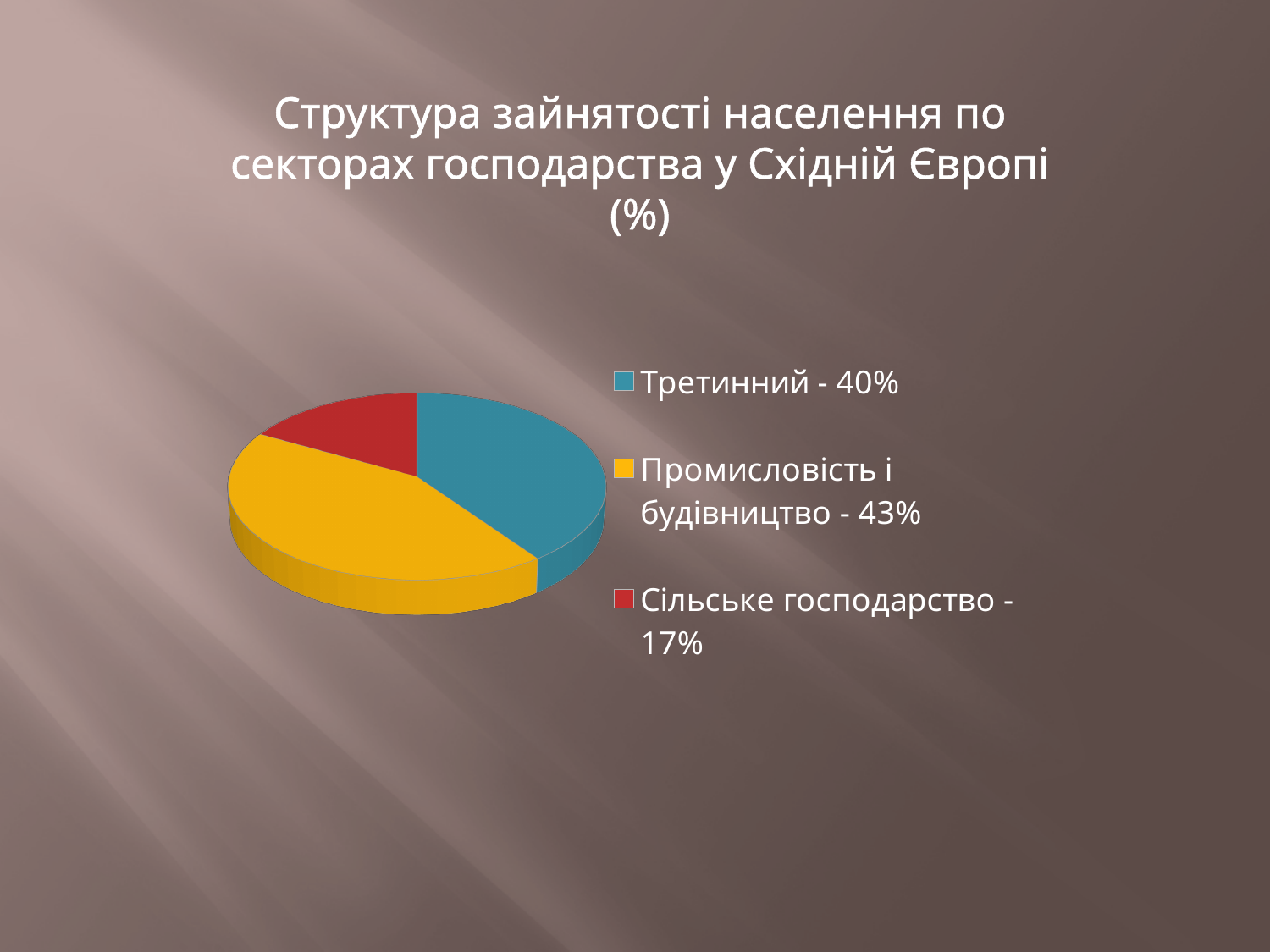
What is the difference in percentage points between Третинний and Сільське господарство? 23 What share of employment does the legend give for Сільське господарство? 17% Which is larger, the share for Третинний or the share for Сільське господарство? Третинний What is the difference in percentage points between Промисловість і будівництво and Третинний? 3 Which sector has the largest share in the pie chart? Промисловість і будівництво What is the title of the chart? Структура зайнятості населення по секторах господарства у Східній Європі (%) Which sector has the smallest share in the pie chart? Сільське господарство What kind of chart is shown on the slide? Pie chart What colour is the slice for Сільське господарство? Red How many slices does the pie chart have? 3 What share of employment does the legend give for Третинний? 40% What share of employment does the legend give for Промисловість і будівництво? 43%